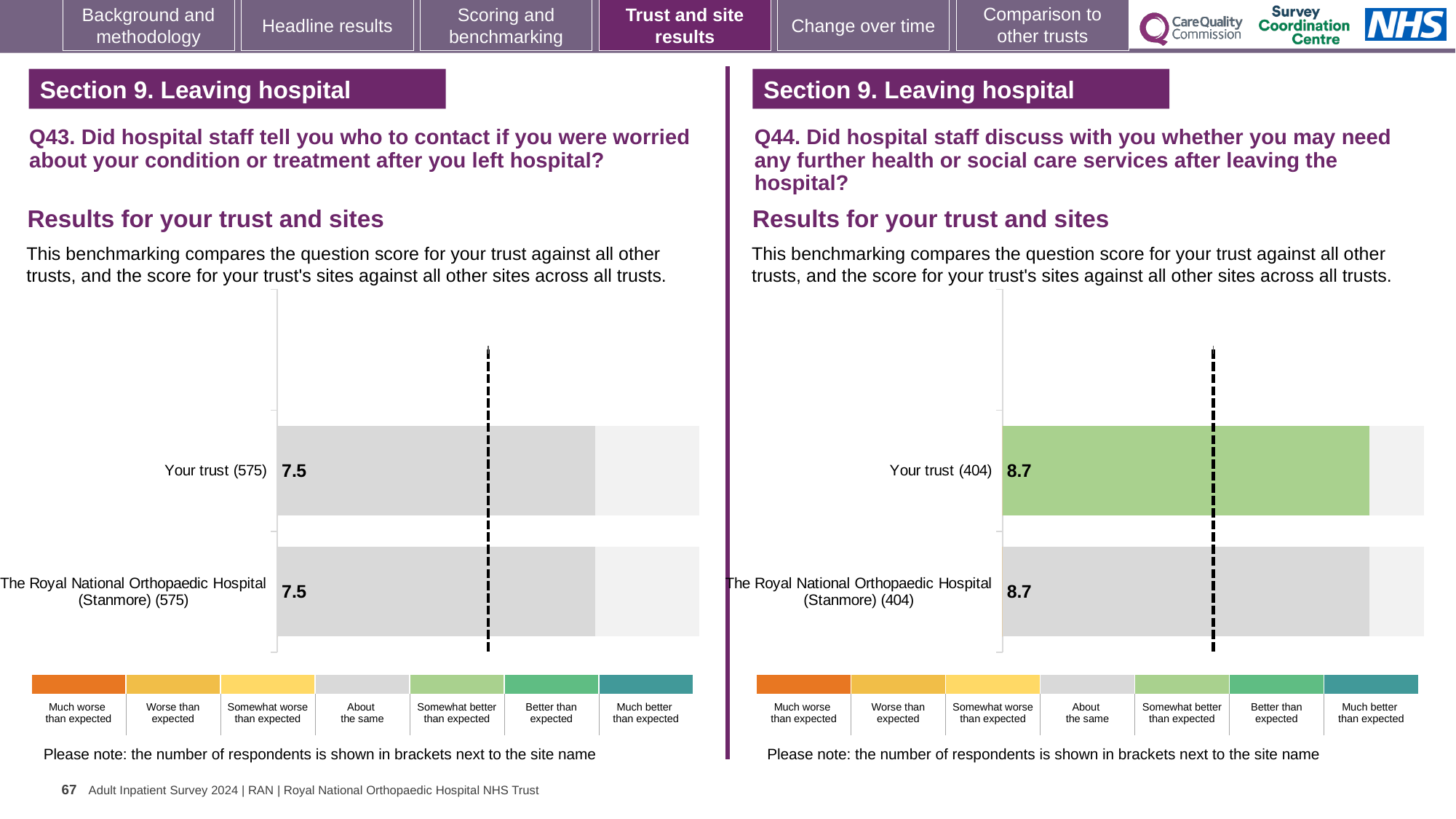
On the Q44 chart (right), what is the score for Your trust? 8.7 On the Q43 chart (left), what is the score for Your trust? 7.5 On the Q44 chart (right), how many respondents are shown in brackets for The Royal National Orthopaedic Hospital (Stanmore)? 404 Is the score for Your trust on the Q44 chart (right) larger or smaller than the score for Your trust on the Q43 chart (left)? Larger On the Q43 chart (left), what is the score for The Royal National Orthopaedic Hospital (Stanmore)? 7.5 On the Q44 chart (right), what is the difference between the score for Your trust and the score for The Royal National Orthopaedic Hospital (Stanmore)? 0 What kind of chart is the Q44 chart (right)? Bar chart How many bars are plotted on the Q44 chart (right)? 2 On the Q44 chart (right), what is the score for The Royal National Orthopaedic Hospital (Stanmore)? 8.7 On the Q43 chart (left), what is the difference between the score for Your trust and the score for The Royal National Orthopaedic Hospital (Stanmore)? 0 On the Q43 chart (left), how many respondents are shown in brackets for Your trust? 575 How many bars are plotted on the Q43 chart (left)? 2